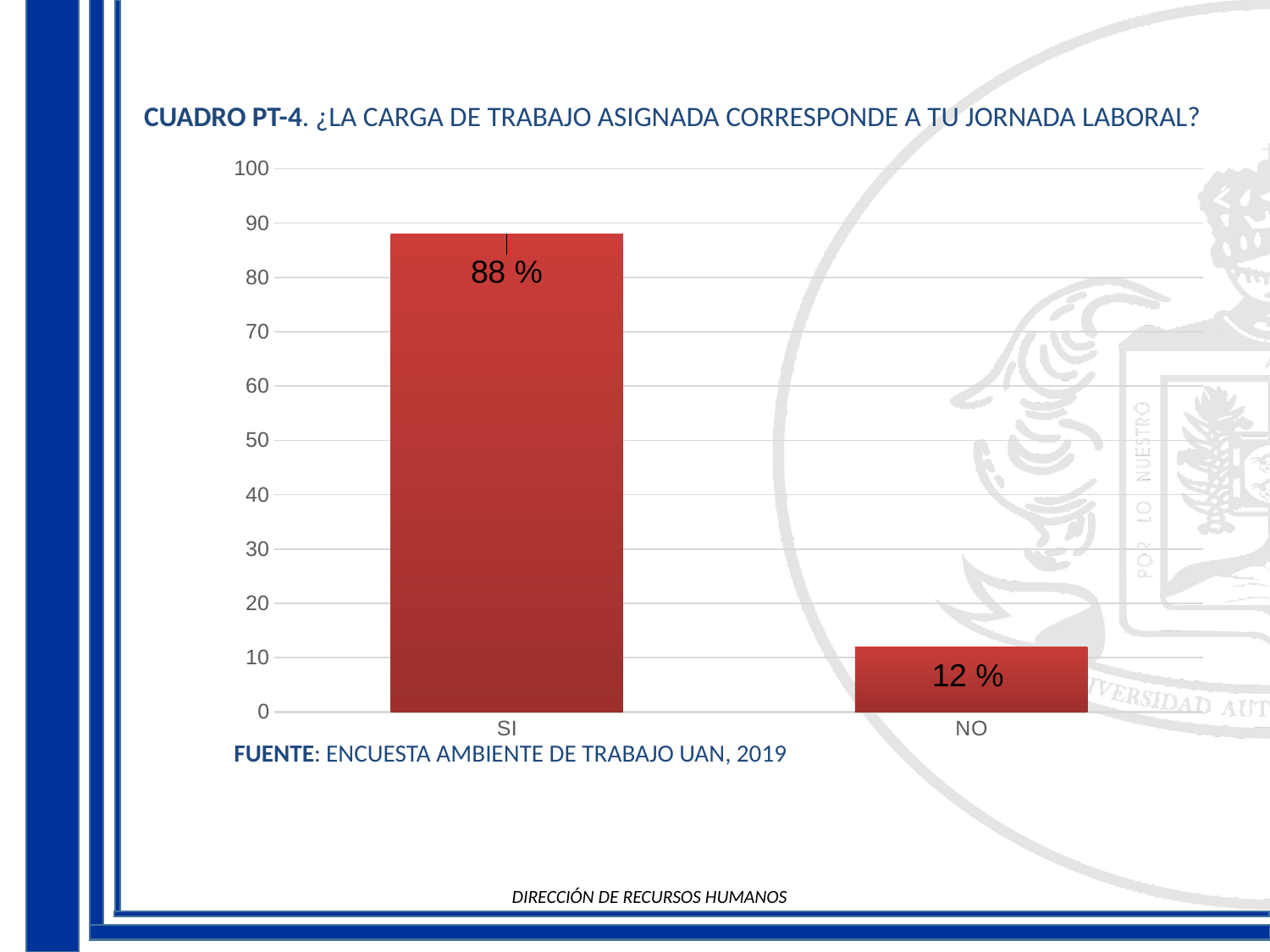
Which category has the highest value? SI Is the value for NO greater or less than 20? less What is the value for NO? 12 % Is the value for SI greater or less than 80? greater How many categories are shown on the x axis? 2 What kind of chart is shown on the slide? bar chart What is the value for SI? 88 % What is the source cited below the chart? ENCUESTA AMBIENTE DE TRABAJO UAN, 2019 What is the maximum value shown on the y axis? 100 Which is larger, the value for SI or the value for NO? SI What is the difference between the values for SI and NO? 76 % Which category has the lowest value? NO